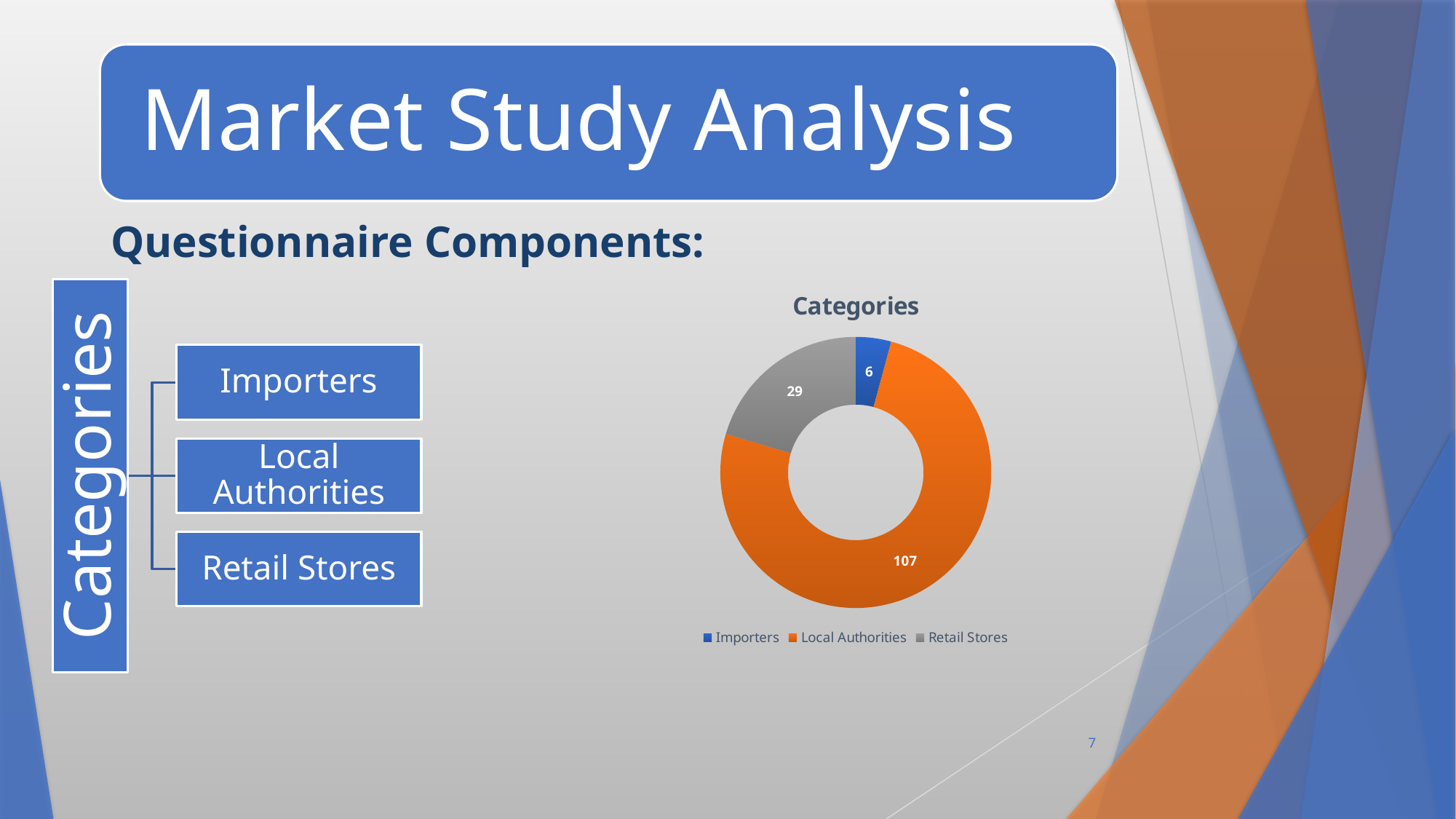
What is the difference between the values for Local Authorities and Retail Stores in the Categories chart? 78 What kind of chart is shown on the slide? doughnut chart How many categories are shown in the Categories chart? 3 What is the total of all values in the Categories chart? 142 What is the value for Local Authorities in the Categories chart? 107 What colour represents Local Authorities in the Categories chart? orange What is the value for Retail Stores in the Categories chart? 29 Which category has the lowest value in the Categories chart? Importers Which category has the highest value in the Categories chart? Local Authorities What is the difference between the values for Retail Stores and Importers in the Categories chart? 23 What is the value for Importers in the Categories chart? 6 Which is larger in the Categories chart, Retail Stores or Importers? Retail Stores